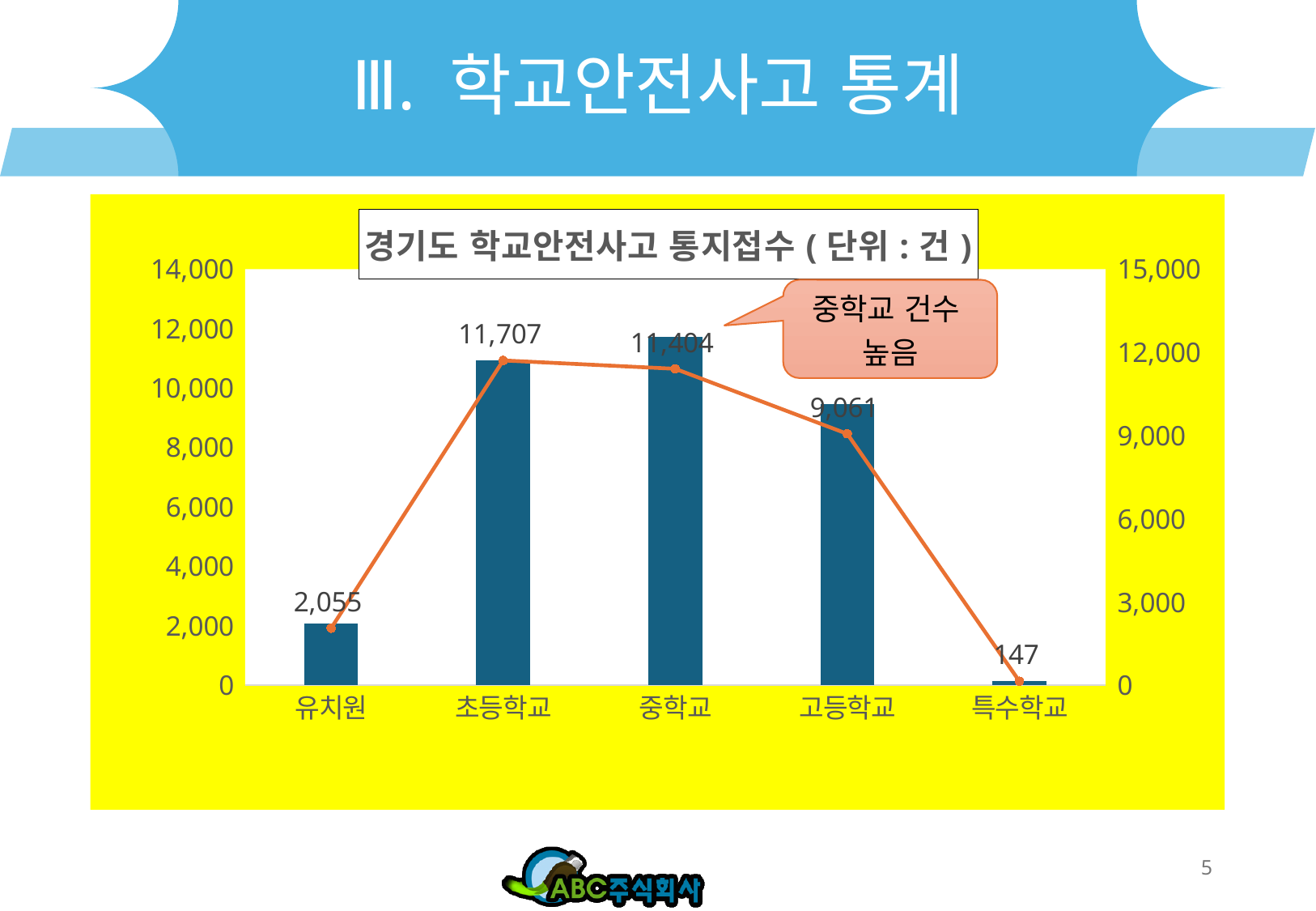
How many categories are shown on the x axis of the chart? 5 What is the value for 특수학교 in the chart? 147 What is the difference between the values for 고등학교 and 유치원? 7,006 Which is larger, the value for 중학교 or the value for 고등학교? 중학교 What is the value for 고등학교 in the chart? 9,061 What is the title of the chart? 경기도 학교안전사고 통지접수 ( 단위 : 건 ) What is the value for 유치원 in the chart? 2,055 What is the value for 초등학교 in the chart? 11,707 Which category has the lowest value in the chart? 특수학교 What is the difference between the values for 초등학교 and 중학교? 303